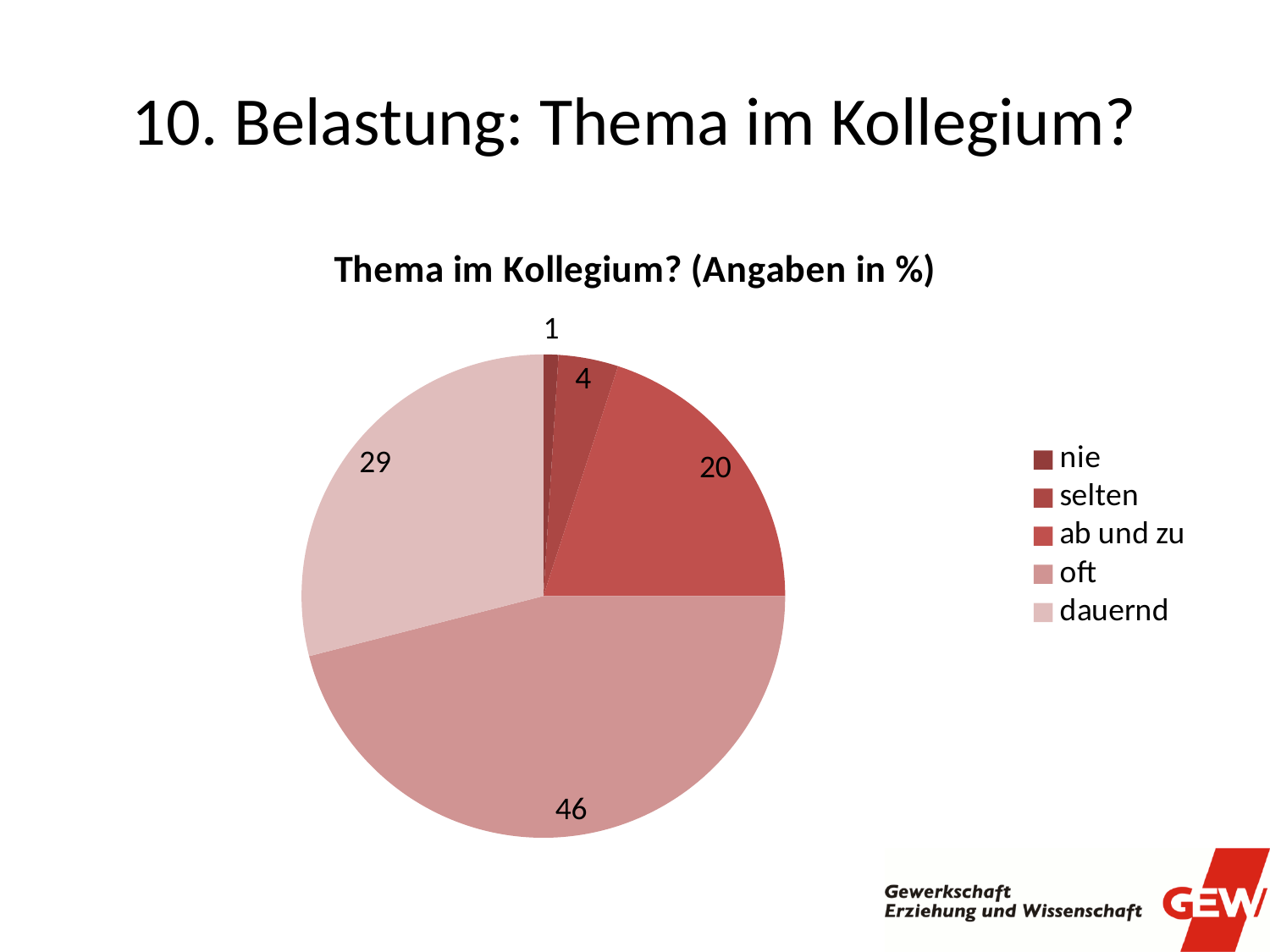
What kind of chart is shown on the slide? pie chart What is the value for "nie" in the pie chart? 1 What is the difference between the values for "oft" and "dauernd"? 17 How many categories does the pie chart show? 5 Which category has the smallest slice of the pie chart? nie What is the title of the chart? Thema im Kollegium? (Angaben in %) Which category has the largest slice of the pie chart? oft What is the value for "selten" in the pie chart? 4 What is the value for "ab und zu" in the pie chart? 20 What is the value for "oft" in the pie chart? 46 What is the value for "dauernd" in the pie chart? 29 Which is larger, the value for "ab und zu" or the value for "dauernd"? dauernd